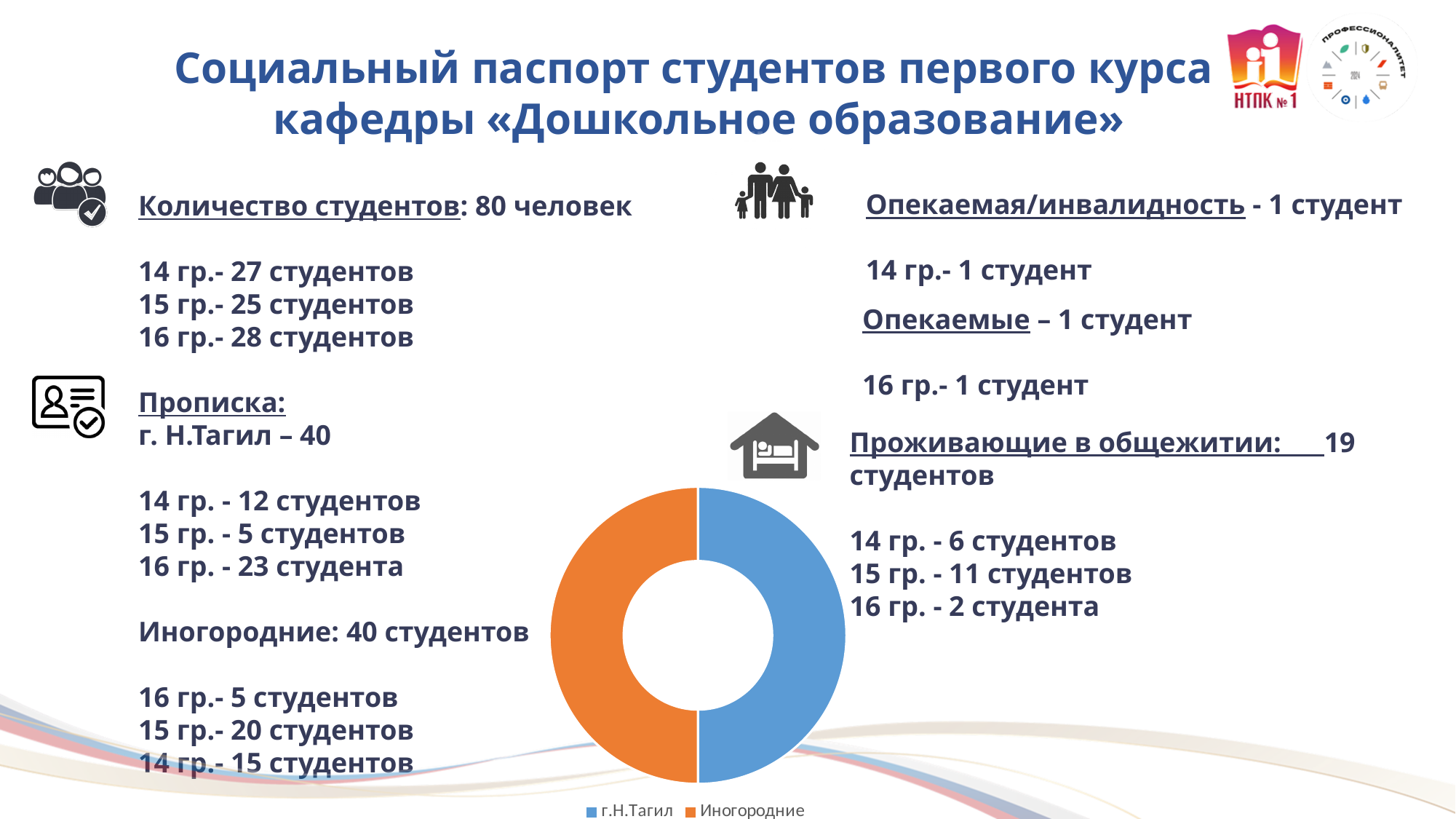
What kind of chart is shown on the slide? Doughnut (pie) chart What is the difference between the number of students from г.Н.Тагил and the number of Иногородние students shown in the chart? 0 Which colour represents г.Н.Тагил in the doughnut chart? Blue What is the total number of students represented by both slices of the doughnut chart? 80 What are the two categories listed in the chart legend? г.Н.Тагил and Иногородние According to the slide, how many students does the Иногородние slice represent? 40 студентов What share of the doughnut chart does the г.Н.Тагил slice take? 50% How many slices does the doughnut chart have? 2 Which colour represents Иногородние in the doughnut chart? Orange According to the slide, how many students does the г.Н.Тагил slice represent? 40 What share of the doughnut chart does the Иногородние slice take? 50%